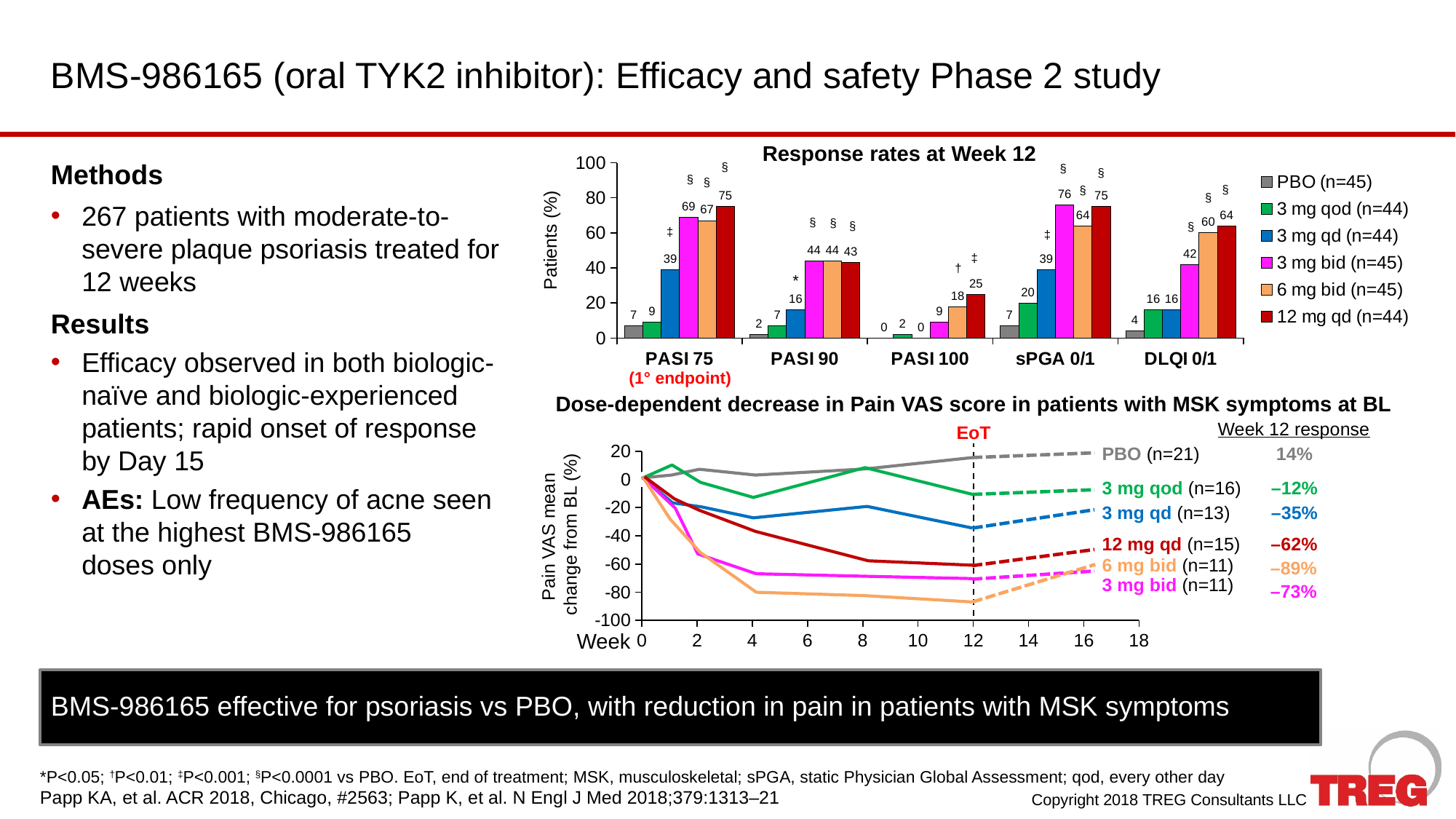
In the 'Response rates at Week 12' chart, which endpoint is marked as the primary (1°) endpoint? PASI 75 In the 'Response rates at Week 12' chart, what is the value for PBO at PASI 90? 2 What type of chart is the 'Dose-dependent decrease in Pain VAS score' chart? Line chart What type of chart is the 'Response rates at Week 12' chart? Bar chart In the Pain VAS chart, what is the Week 12 response for PBO? 14% In the 'Response rates at Week 12' chart, what is the value for 12 mg qd at PASI 75? 75 In the Pain VAS chart, what is the Week 12 response for 6 mg bid? –89% In the 'Response rates at Week 12' chart, which is larger at DLQI 0/1: 6 mg bid or 3 mg bid? 6 mg bid In the 'Response rates at Week 12' chart, which treatment group has the highest value at sPGA 0/1? 3 mg bid In the 'Response rates at Week 12' chart, what is the difference between the 12 mg qd and PBO values at PASI 100? 25 How many treatment groups does the legend of the 'Response rates at Week 12' chart list? 6 How many endpoint categories are shown on the x axis of the 'Response rates at Week 12' chart? 5